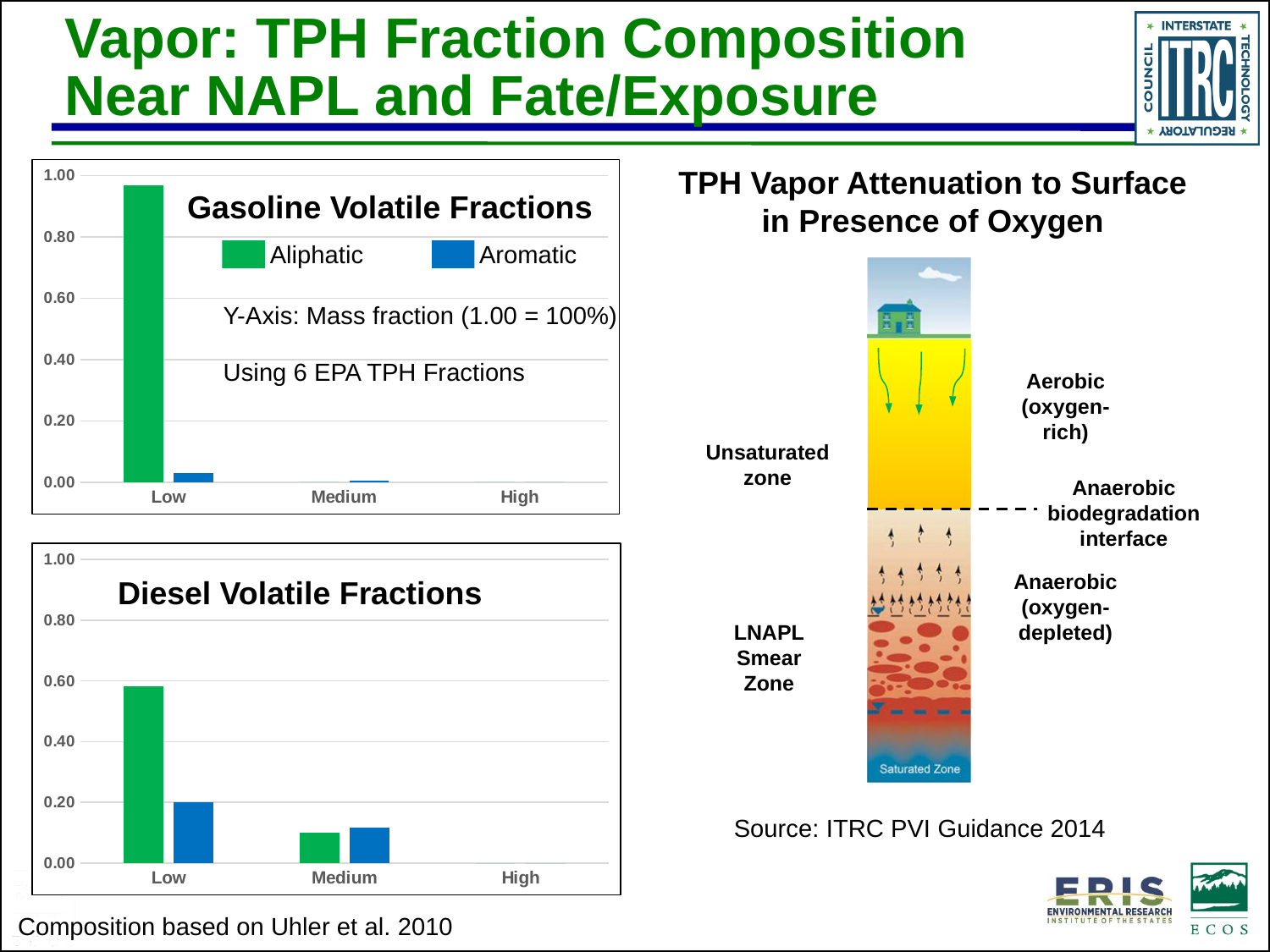
In the Diesel Volatile Fractions chart, is the Aliphatic value for Medium greater or less than 0.20? less In the Gasoline Volatile Fractions chart, which category has the highest Aliphatic value? Low In the Gasoline Volatile Fractions chart, is the Aromatic value for Low greater or less than 0.20? less How many series does the legend of the Gasoline Volatile Fractions chart list? 2 In the Diesel Volatile Fractions chart, do the Aliphatic values rise or fall from Low to High? fall In the Diesel Volatile Fractions chart, is the Aliphatic value for Low greater or less than 0.40? greater What kind of chart is the Gasoline Volatile Fractions chart? bar chart Which colour represents the Aromatic series in the Gasoline Volatile Fractions chart? blue In the Diesel Volatile Fractions chart, which is larger for the Low category, Aliphatic or Aromatic? Aliphatic In the Diesel Volatile Fractions chart, which category has the highest Aromatic value? Low How many categories are shown on the x axis of the Diesel Volatile Fractions chart? 3